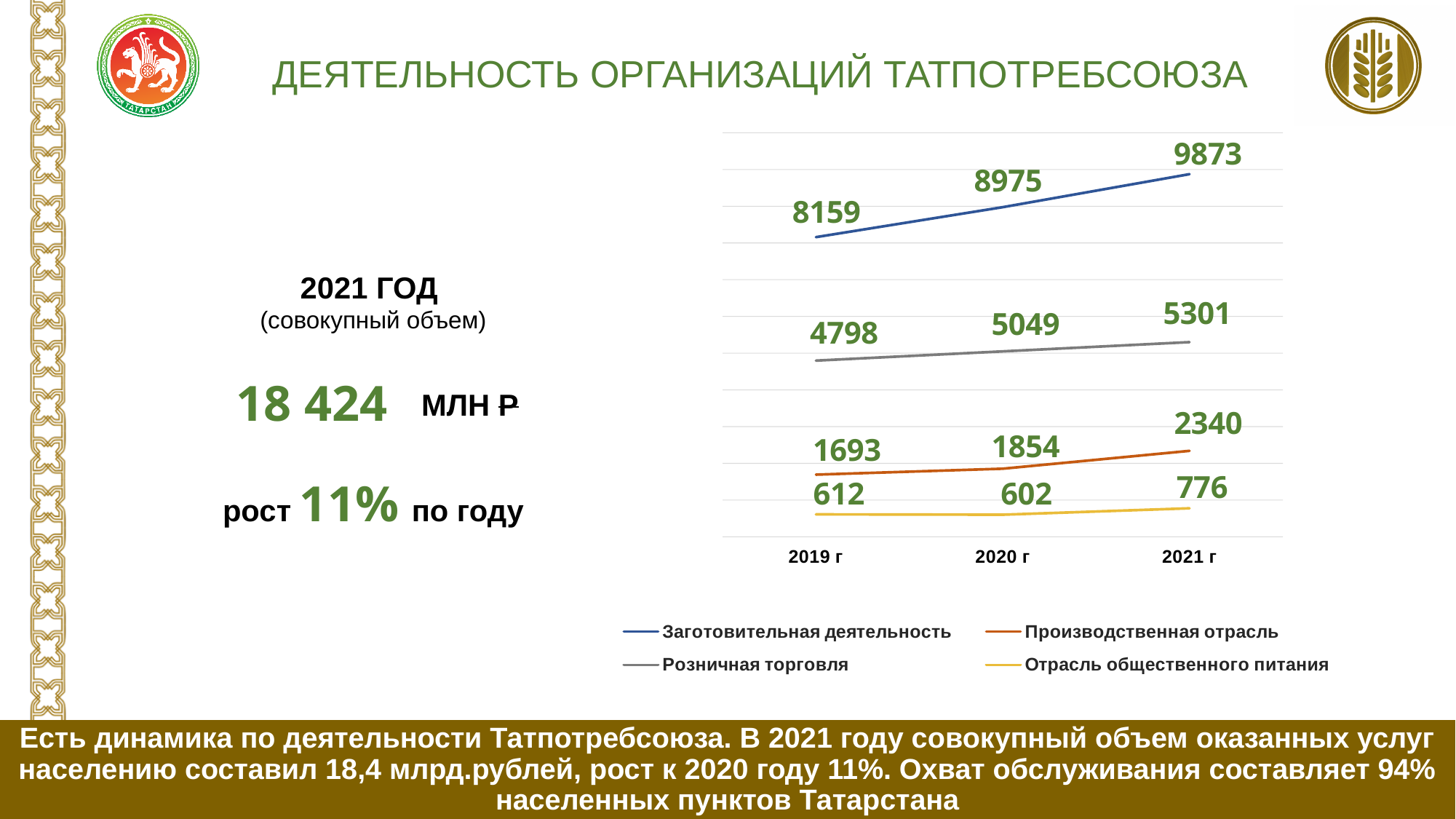
What is the value for Розничная торговля in 2019 г? 4798 How many years are shown on the x axis of the chart? 3 What is the value for Заготовительная деятельность in 2021 г? 9873 What type of chart is shown on the slide? line chart What is the difference between the Заготовительная деятельность values for 2021 г and 2019 г? 1714 Which is larger: Розничная торговля in 2020 г or Производственная отрасль in 2021 г? Розничная торговля in 2020 г What is the value for Производственная отрасль in 2021 г? 2340 How many series does the chart legend list? 4 Which series has the lowest value in 2019 г? Отрасль общественного питания Which series has the highest value in 2021 г? Заготовительная деятельность Does the value for Отрасль общественного питания rise or fall from 2019 г to 2020 г? fall What is the value for Отрасль общественного питания in 2020 г? 602